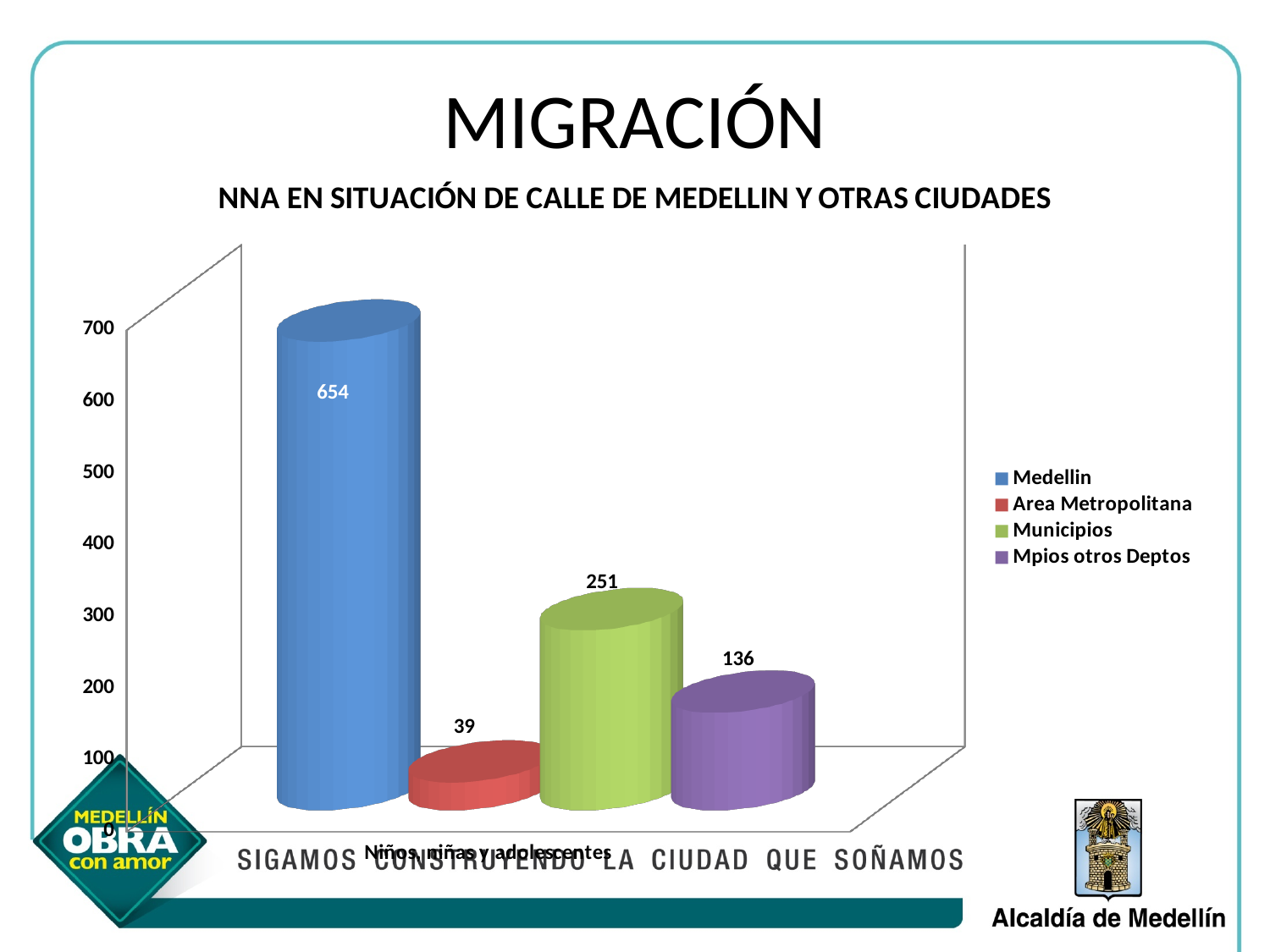
What is the difference between the values for Medellin and Municipios? 403 What is the value for Area Metropolitana? 39 Which series has the lowest value? Area Metropolitana How many series does the legend list? 4 Which series has the highest value? Medellin What is the difference between the values for Municipios and Mpios otros Deptos? 115 Which is larger, the value for Municipios or the value for Mpios otros Deptos? Municipios What is the value for Municipios? 251 What kind of chart is shown on the slide? Bar chart What is the value for Medellin? 654 What is the value for Mpios otros Deptos? 136 What is the title of the chart? NNA EN SITUACIÓN DE CALLE DE MEDELLIN Y OTRAS CIUDADES